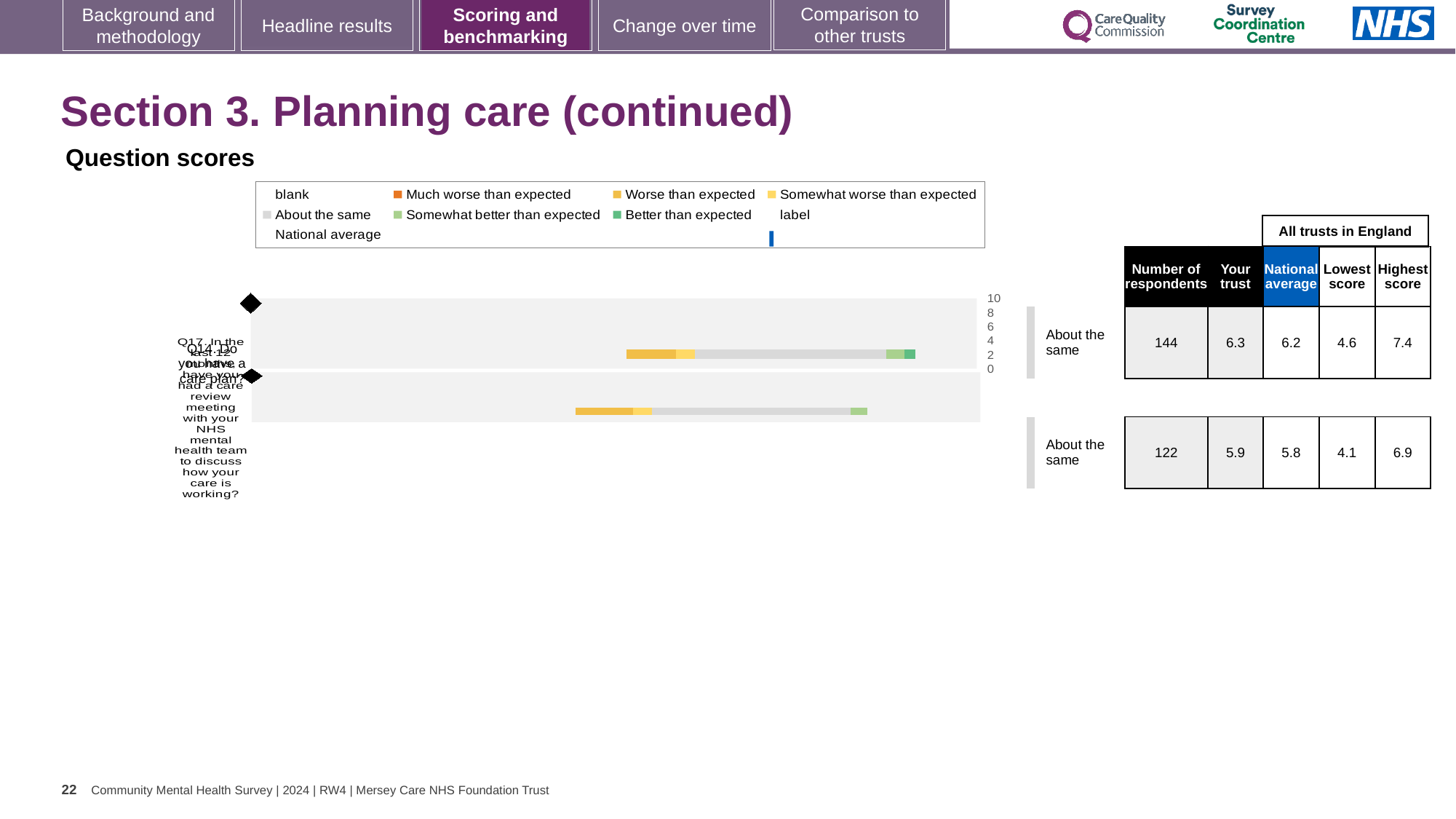
What kind of chart is shown on the slide? bar chart What is the number of respondents for the top question row? 144 What is the 'Your trust' score for the top question row? 6.3 What is the highest value shown on the chart's score axis? 10 What is the number of respondents for the bottom question row? 122 What is the national average for the top question row? 6.2 What benchmark category is shown next to the bottom question row? About the same What is the highest score among all trusts in England for the top question row? 7.4 What is the lowest score among all trusts in England for the bottom question row? 4.1 How many question rows are plotted in the chart? 2 What is the difference between the 'Your trust' score and the national average for the bottom question row? 0.1 Which question row has the higher 'Your trust' score, the top row or the bottom row? top row